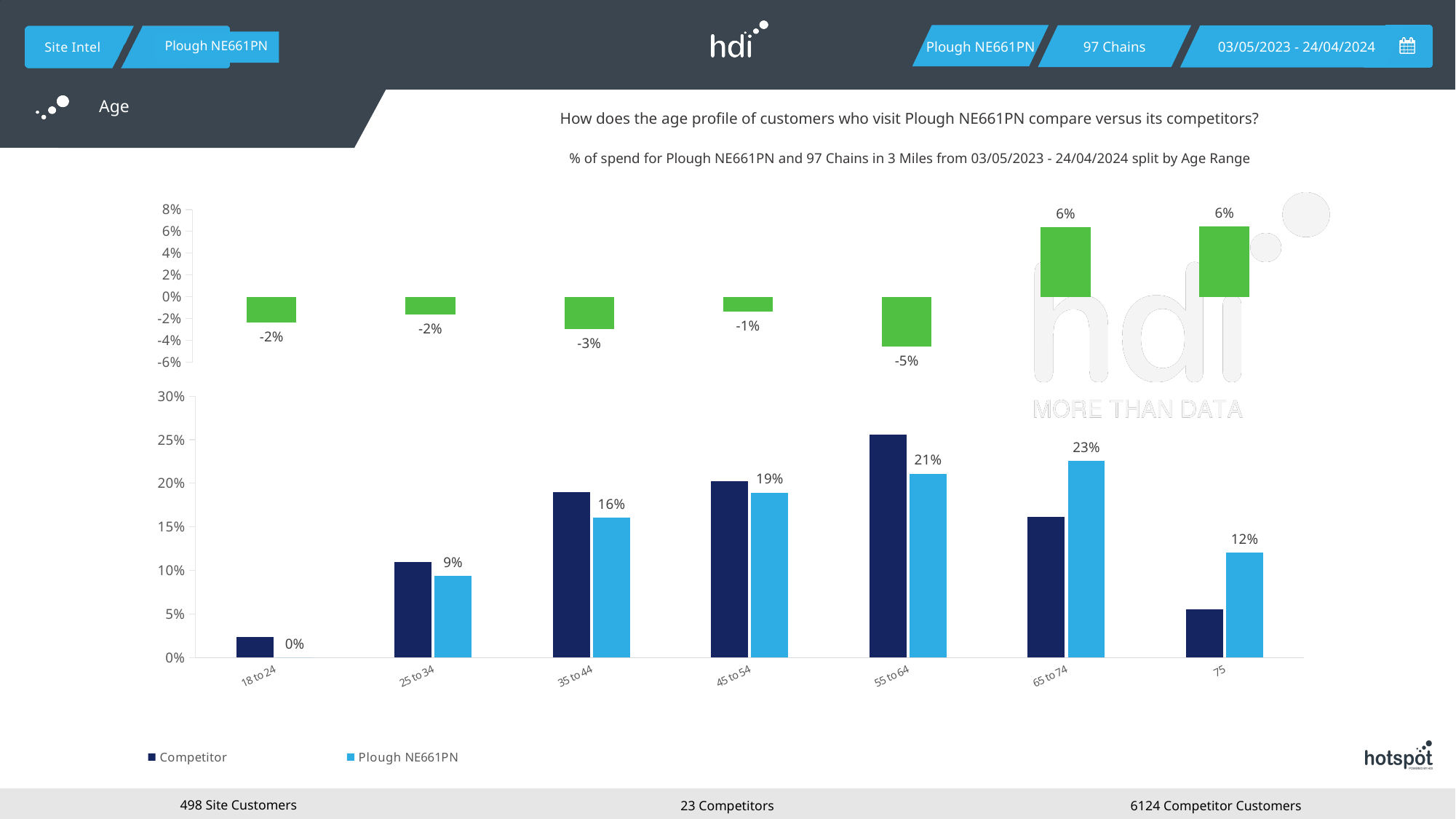
In the bottom chart, is the Competitor value for 18 to 24 greater or less than 5%? less In the bottom chart, which age range has the lowest value for Plough NE661PN? 18 to 24 What kind of chart is the bottom chart? Bar chart How many age range categories are shown on the x axis of the bottom chart? 7 In the bottom chart, is the Competitor value for 55 to 64 greater or less than 25%? greater In the bottom chart, what is the difference between the Plough NE661PN values for 65 to 74 and 75? 11% In the bottom chart, what is the value for Plough NE661PN in the 25 to 34 age range? 9% In the top chart, what is the value shown for the 55 to 64 age range? -5% How many series does the legend of the bottom chart list? 2 In the bottom chart, which age range has the highest value for Plough NE661PN? 65 to 74 In the bottom chart, what is the value for Plough NE661PN in the 65 to 74 age range? 23% In the bottom chart, which is larger for the 45 to 54 age range, Competitor or Plough NE661PN? Competitor